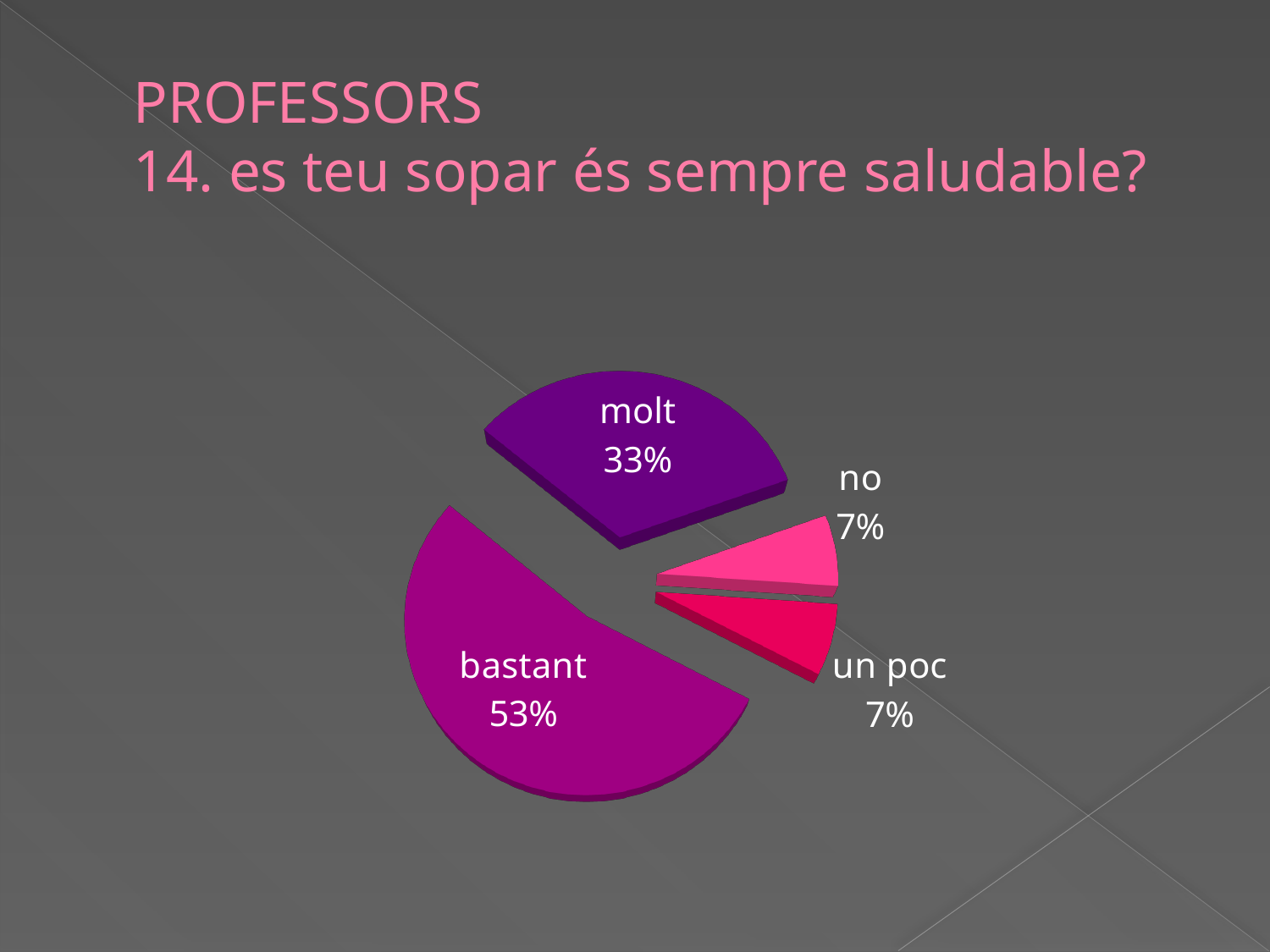
Which group of respondents does the slide title refer to? PROFESSORS What percentage of the pie is labelled "bastant"? 53% Which category has the largest slice of the pie? bastant What percentage of the pie is labelled "molt"? 33% What question does the slide title say the chart is about? 14. es teu sopar és sempre saludable? What kind of chart is shown on the slide? pie chart Which slice is larger, "molt" or "no"? molt What percentage of the pie is labelled "un poc"? 7% How many slices does the pie chart have? 4 What percentage of the pie is labelled "no"? 7% What is the difference in percentage points between the "bastant" slice and the "molt" slice? 20 What is the combined share of the "no" and "un poc" slices? 14%